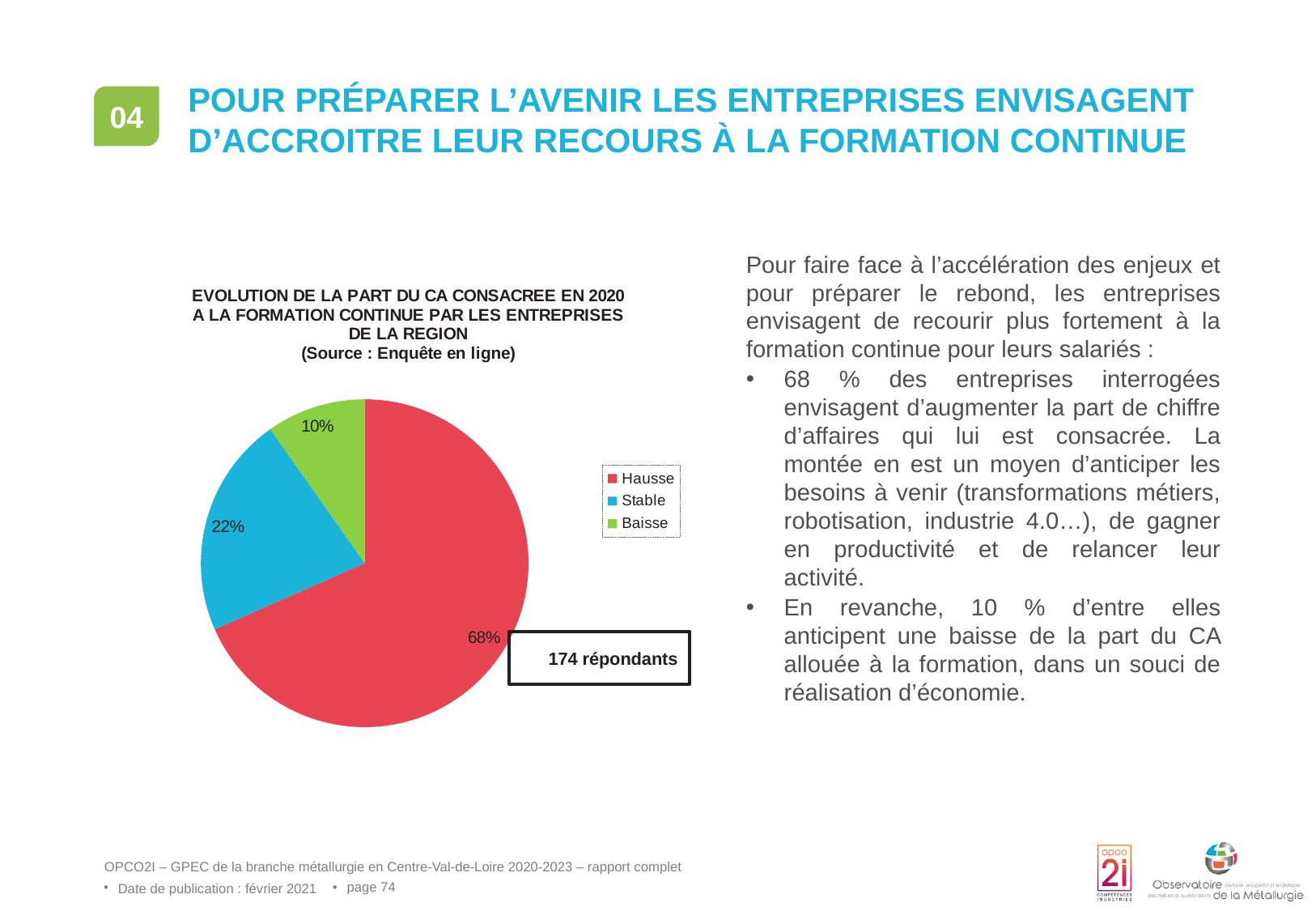
What share of the pie does the Stable slice represent? 22% What is the difference in percentage points between the Hausse and Stable slices? 46 Which is larger, the Stable slice or the Baisse slice? Stable Which category has the largest slice of the pie? Hausse Which category has the smallest slice of the pie? Baisse What kind of chart is shown on the slide? Pie chart What colour is the Hausse slice in the pie chart? Red How many respondents does the chart indicate? 174 répondants What is the difference in percentage points between the Stable and Baisse slices? 12 How many slices does the pie chart have? 3 What share of the pie does the Baisse slice represent? 10% What share of the pie does the Hausse slice represent? 68%